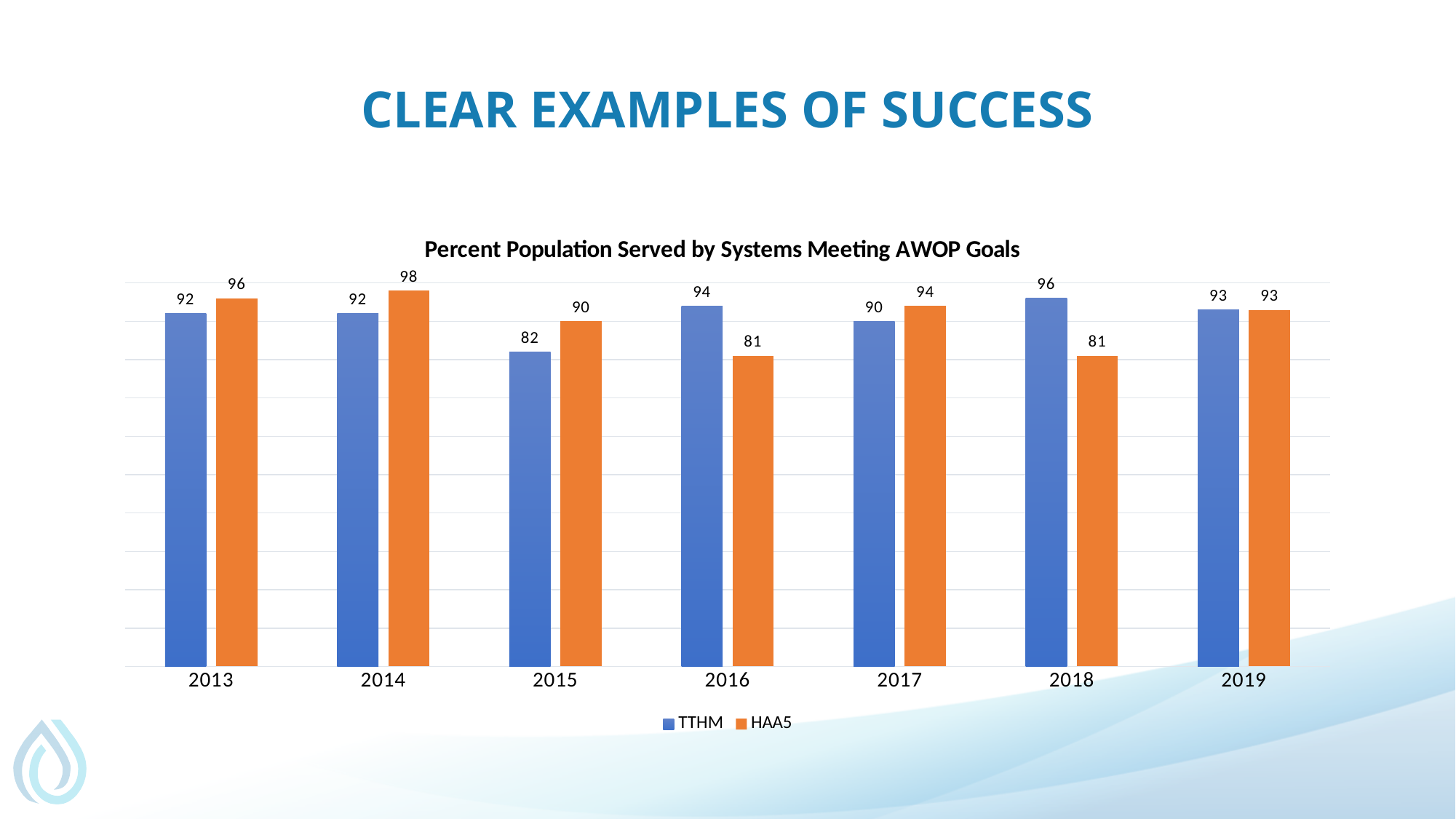
Which is larger in 2013, the TTHM value or the HAA5 value? HAA5 What is the HAA5 value for 2016? 81 What is the HAA5 value for 2014? 98 In which year is the TTHM value lowest? 2015 In which year is the TTHM value highest? 2018 How many years are shown on the x axis? 7 What is the difference between the HAA5 and TTHM values in 2016? 13 What is the difference between the TTHM and HAA5 values in 2018? 15 What type of chart is shown on the slide? Bar chart What is the TTHM value for 2015? 82 In which year is the HAA5 value highest? 2014 How many series does the legend list? 2